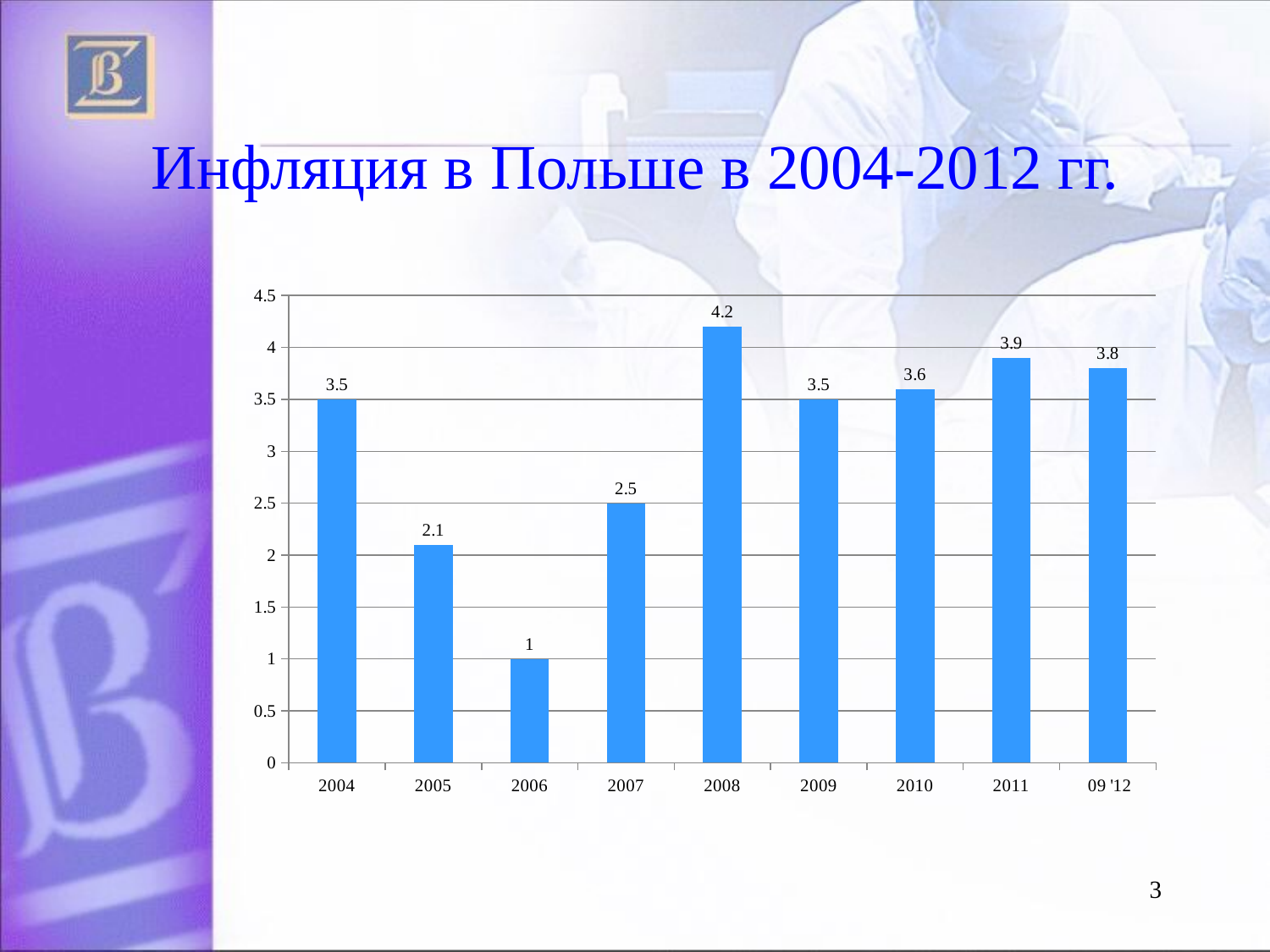
What kind of chart is shown on the slide? bar chart Which year has the lowest value on the chart? 2006 What is the inflation value shown for 2008? 4.2 What is the value shown for 2006? 1 What is the title of the slide? Инфляция в Польше в 2004-2012 гг. Is the value for 2011 greater or less than 3.5? greater What is the difference between the values for 2008 and 2006? 3.2 How many bars are shown on the chart? 9 Which year has the highest value on the chart? 2008 Which is larger, the value for 2005 or the value for 2007? 2007 What is the value shown for 09 '12? 3.8 What is the difference between the values for 2011 and 2010? 0.3